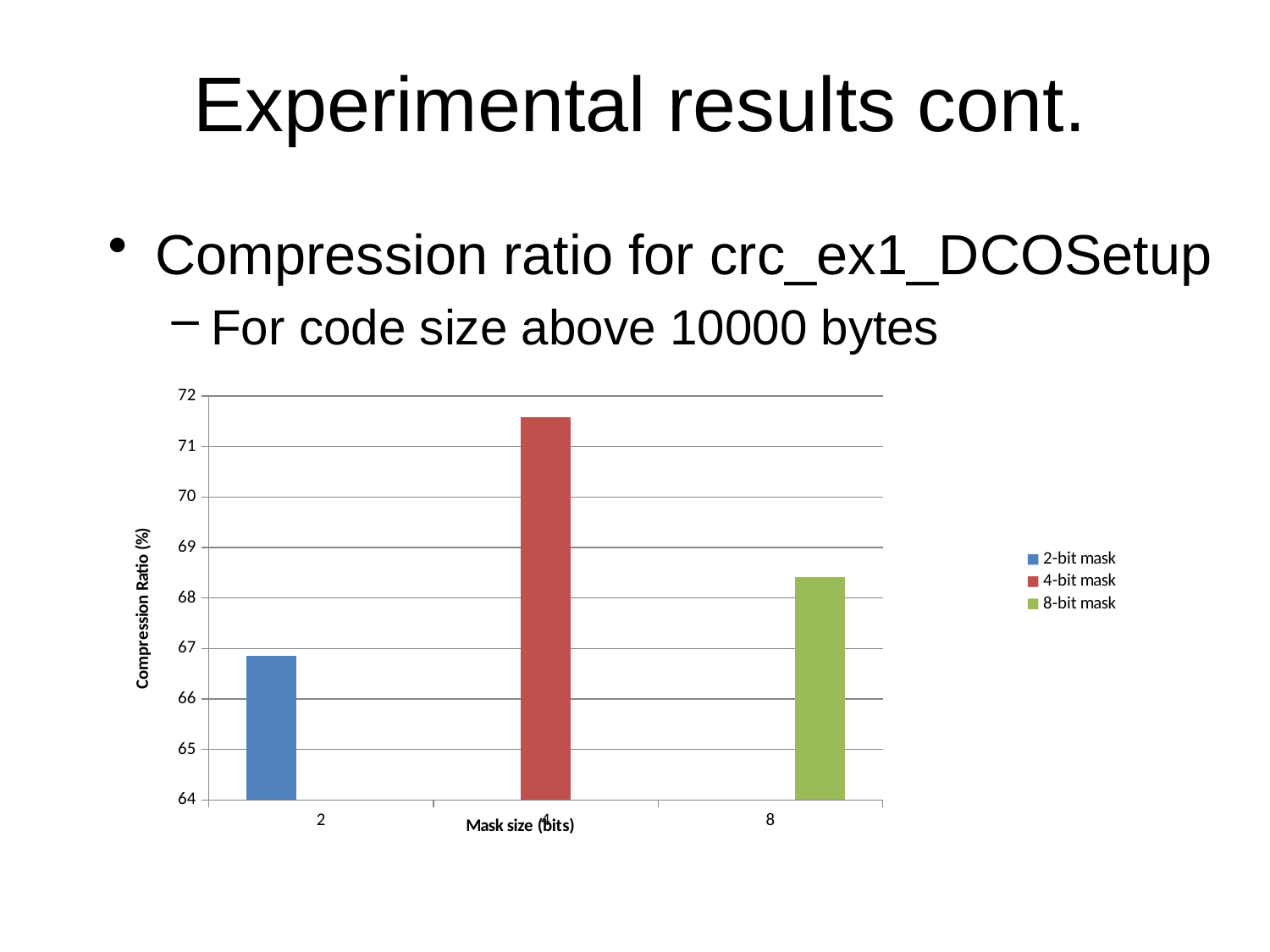
Is the compression ratio for the 8-bit mask greater or less than 68? greater What is the title of the horizontal axis? Mask size (bits) Is the compression ratio for the 4-bit mask greater or less than 71? greater How many series does the legend list? 3 What kind of chart is shown on the slide? bar chart Is the compression ratio for the 2-bit mask greater or less than 67? less Which mask size has the lowest compression ratio? 2-bit mask What is the title of the vertical axis? Compression Ratio (%) Which has a larger compression ratio, the 4-bit mask or the 8-bit mask? 4-bit mask Which has a larger compression ratio, the 8-bit mask or the 2-bit mask? 8-bit mask How many bars are plotted in the chart? 3 Which mask size has the highest compression ratio? 4-bit mask